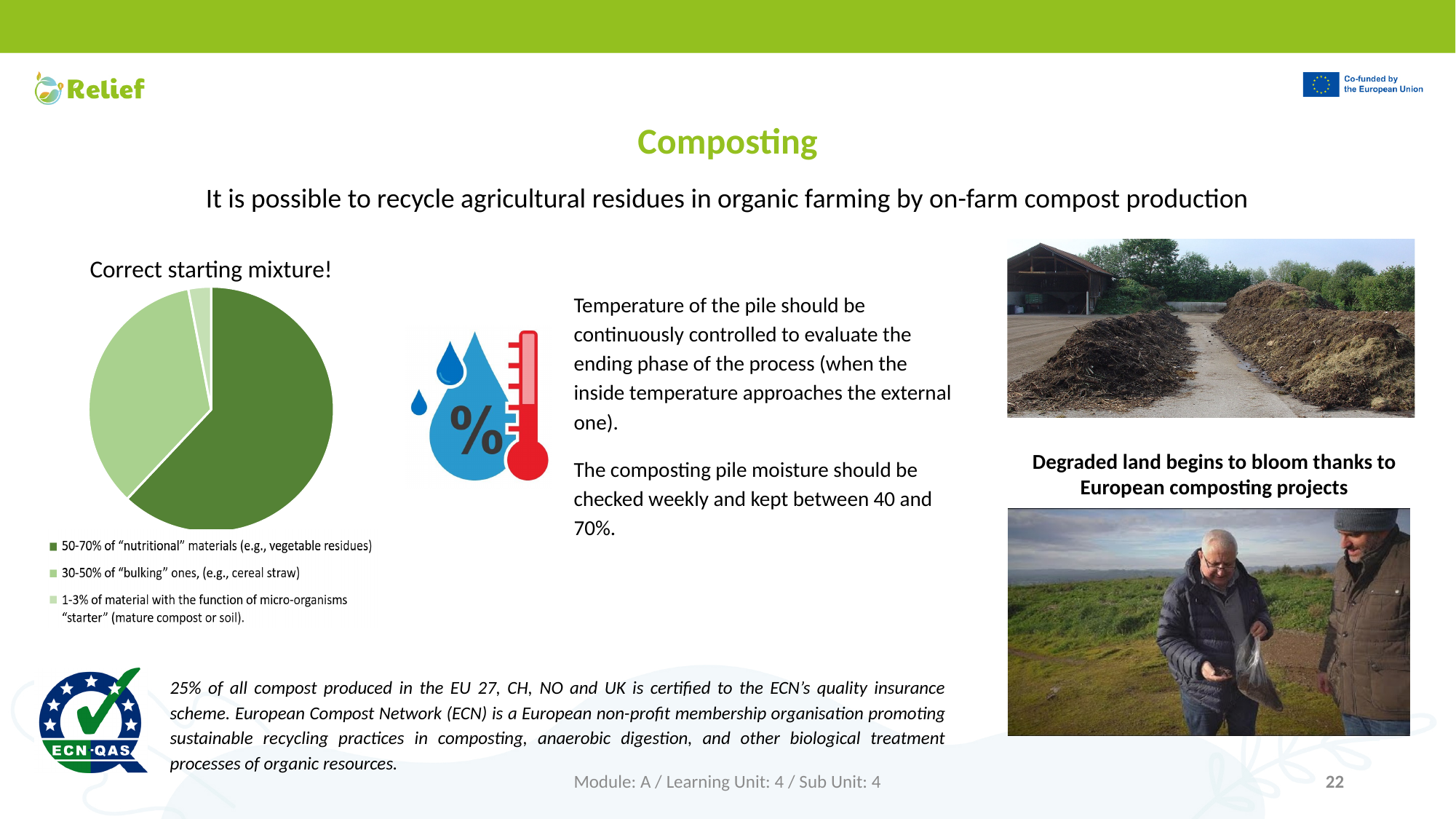
What kind of chart is shown under the heading "Correct starting mixture!"? Pie chart According to the pie chart legend, what example is given for "nutritional" materials? Vegetable residues How many slices does the "Correct starting mixture!" pie chart have? 3 What is the title shown above the pie chart? Correct starting mixture! How many entries does the legend of the "Correct starting mixture!" pie chart list? 3 According to the pie chart legend, what example is given for "bulking" materials? Cereal straw Which legend entry of the pie chart is shown in the darkest green? 50-70% of "nutritional" materials (e.g., vegetable residues) In the "Correct starting mixture!" pie chart, which slice is larger: "nutritional" materials or "bulking" ones? "Nutritional" materials Which slice of the "Correct starting mixture!" pie chart is the largest? 50-70% of "nutritional" materials (e.g., vegetable residues) In the "Correct starting mixture!" pie chart, which slice is larger: "bulking" ones or the micro-organisms "starter" material? "Bulking" ones Which slice of the "Correct starting mixture!" pie chart is the smallest? 1-3% of material with the function of micro-organisms "starter" (mature compost or soil)